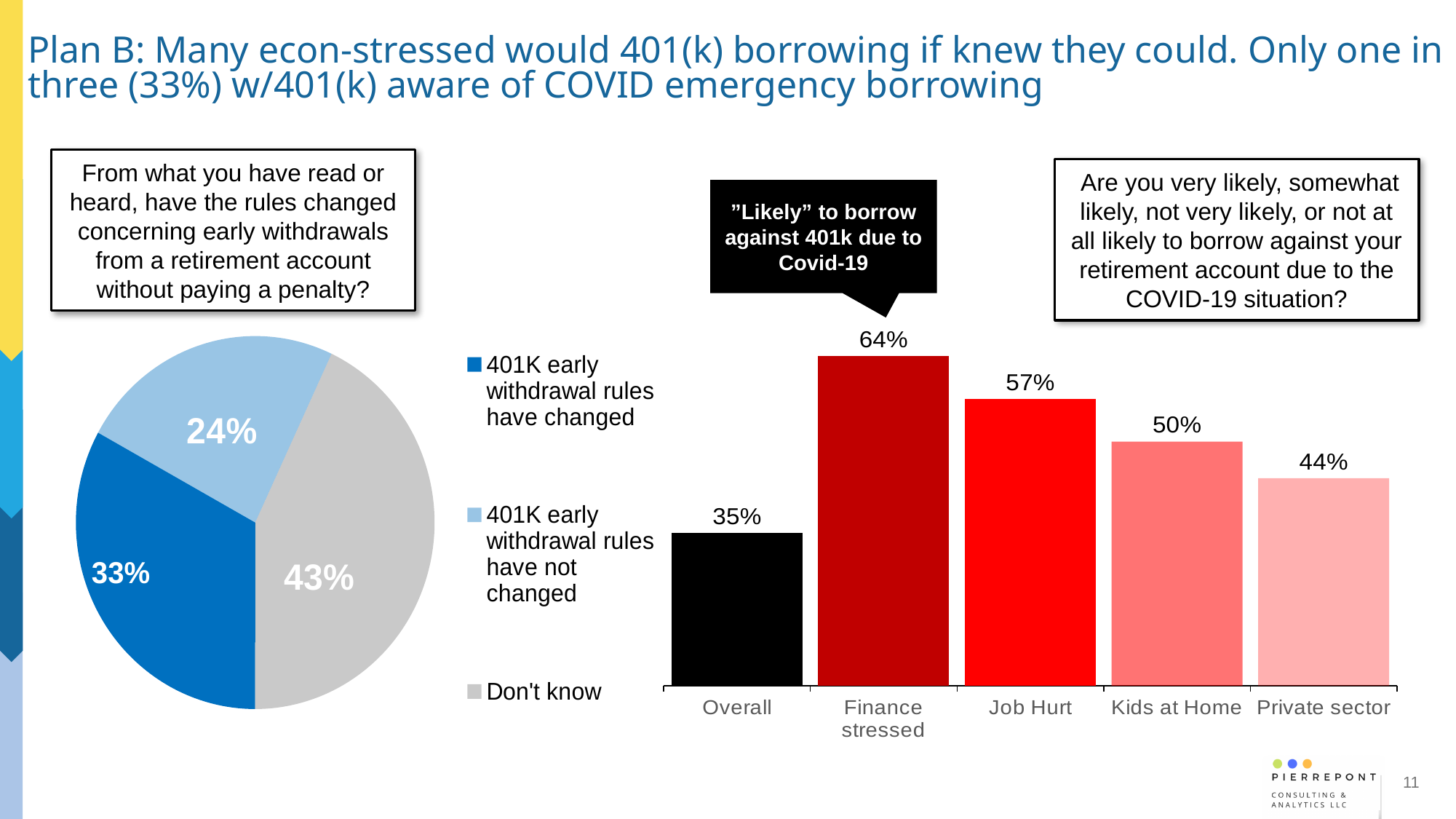
What type of chart is the chart on the right? Bar chart In the pie chart on the left, how many slices are there? 3 In the bar chart on the right, what is the value for Finance stressed? 64% In the pie chart on the left, which response has the smallest share? 401K early withdrawal rules have not changed In the pie chart on the left, what share of respondents answered Don't know? 43% In the pie chart on the left, what share of respondents said 401K early withdrawal rules have changed? 33% In the pie chart on the left, what is the difference between the Don't know share and the share saying rules have changed? 10% In the bar chart on the right, what is the difference between Job Hurt and Private sector? 13% In the bar chart on the right, what is the value for Overall? 35% In the bar chart on the right, which category has the highest value? Finance stressed In the bar chart on the right, which is larger, Kids at Home or Private sector? Kids at Home In the bar chart on the right, which category has the lowest value? Overall